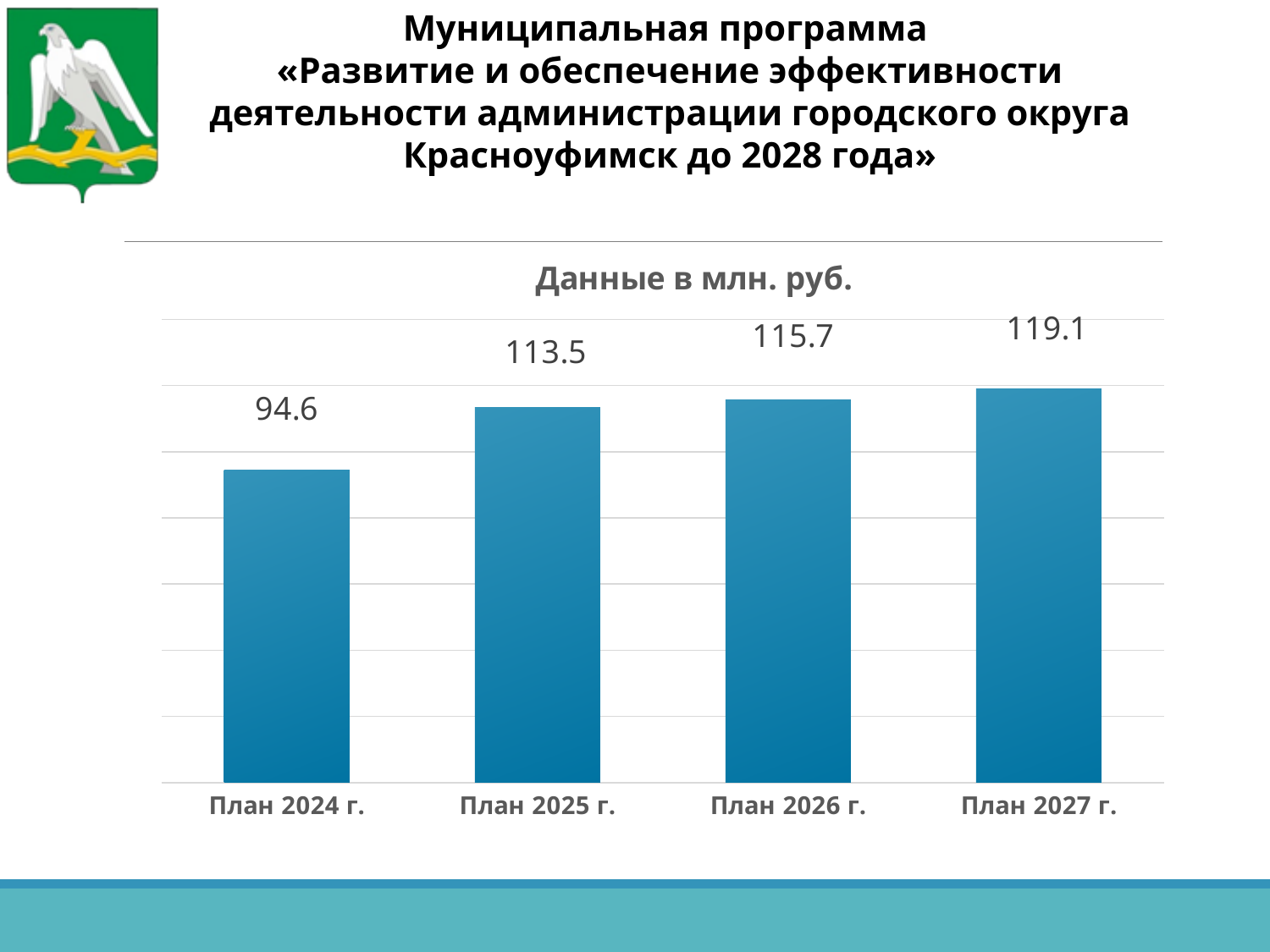
What is the difference between the values for План 2027 г. and План 2026 г.? 3.4 What is the value for План 2025 г.? 113.5 What is the value for План 2026 г.? 115.7 What is the value for План 2024 г.? 94.6 What is the value for План 2027 г.? 119.1 How many categories are shown on the x axis? 4 What is the difference between the values for План 2025 г. and План 2024 г.? 18.9 Which category has the lowest value? План 2024 г. Which category has the highest value? План 2027 г. What kind of chart is shown on the slide? bar chart Do the values rise or fall from План 2024 г. to План 2027 г.? rise Which is larger, the value for План 2026 г. or the value for План 2025 г.? План 2026 г.